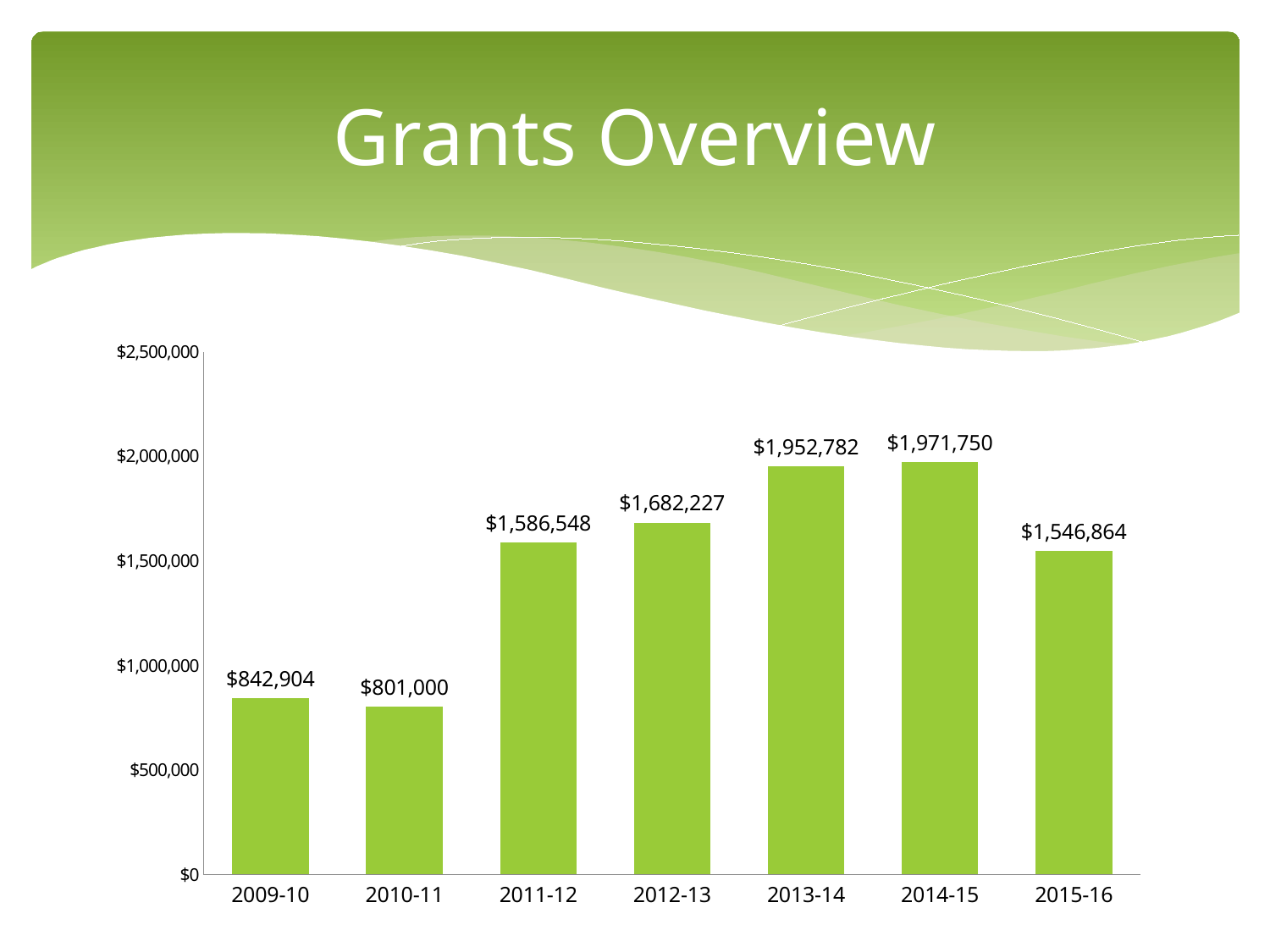
What kind of chart is shown on the slide? bar chart How many years are shown on the chart? 7 Which year has the highest grant value? 2014-15 What is the grant value for 2015-16? $1,546,864 Is the value for 2010-11 greater or less than $1,000,000? less What is the grant value for 2009-10? $842,904 Which year has the lowest grant value? 2010-11 What is the difference between the grant values for 2012-13 and 2011-12? $95,679 From 2010-11 to 2014-15, do the grant values rise or fall? rise What is the difference between the grant values for 2014-15 and 2013-14? $18,968 Which is larger, the grant value for 2012-13 or for 2015-16? 2012-13 What is the grant value for 2011-12? $1,586,548